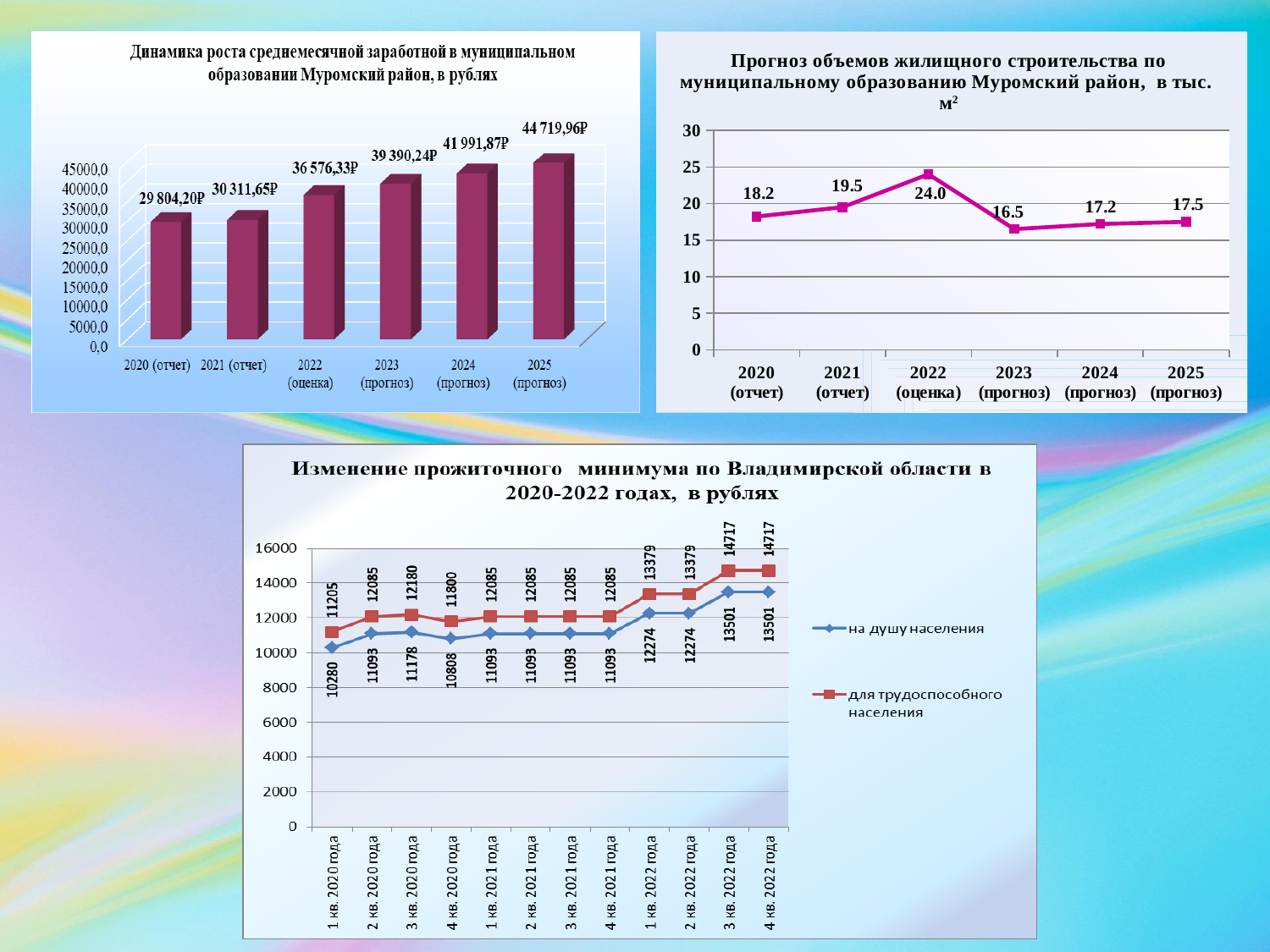
In the top-right chart (Прогноз объемов жилищного строительства), how many data points are plotted? 6 In the bottom chart (Изменение прожиточного минимума), how many quarters are shown on the x axis? 12 In the top-right chart (Прогноз объемов жилищного строительства), what is the value for 2022 (оценка)? 24.0 In the top-left chart (Динамика роста среднемесячной заработной платы), which year has the highest value? 2025 (прогноз) In the top-left chart (Динамика роста среднемесячной заработной платы), what kind of chart is it? Bar chart In the bottom chart (Изменение прожиточного минимума), what is the difference between 'для трудоспособного населения' and 'на душу населения' in 1 кв. 2020 года? 925 In the bottom chart (Изменение прожиточного минимума), how many series does the legend list? 2 In the bottom chart (Изменение прожиточного минимума), what is the value for 'для трудоспособного населения' in 3 кв. 2022 года? 14717 In the top-left chart (Динамика роста среднемесячной заработной платы), what is the difference between the 2021 (отчет) and 2020 (отчет) values? 507,45₽ In the top-right chart (Прогноз объемов жилищного строительства), is the value for 2021 (отчет) larger or smaller than the value for 2024 (прогноз)? Larger In the top-left chart (Динамика роста среднемесячной заработной платы), what is the value for 2022 (оценка)? 36 576,33₽ In the top-right chart (Прогноз объемов жилищного строительства), which year has the lowest value? 2023 (прогноз)